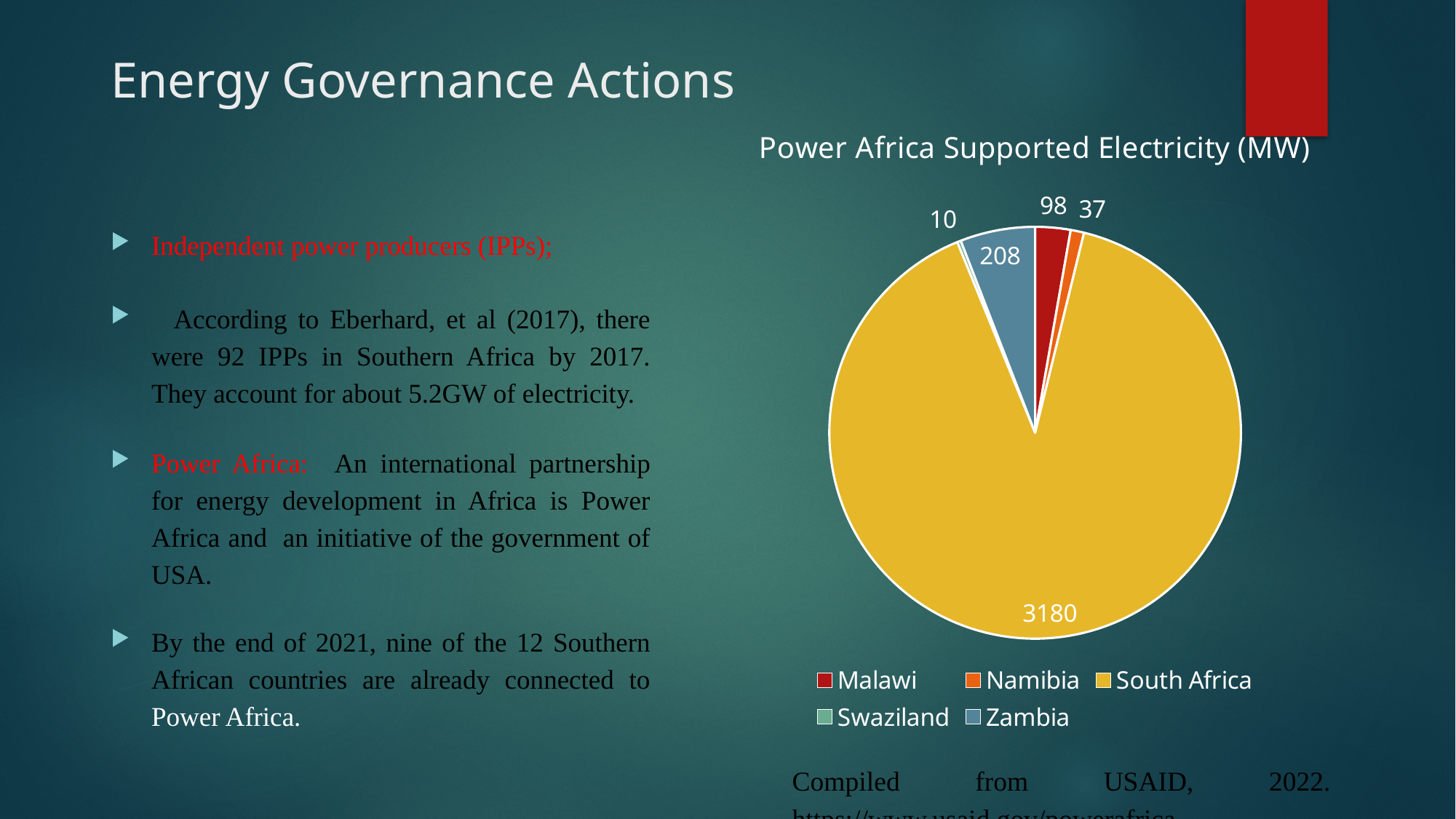
What is the total of all the values shown in the pie chart? 3533 What is the value for Malawi in the pie chart? 98 Which is larger, the value for Malawi or the value for Namibia? Malawi How many countries are listed in the chart legend? 5 What is the value for Zambia in the pie chart? 208 What is the title of the chart? Power Africa Supported Electricity (MW) What is the difference between the values for Zambia and Malawi? 110 What is the value for South Africa in the pie chart? 3180 What is the value for Swaziland in the pie chart? 10 Which country has the smallest slice in the pie chart? Swaziland Which country has the largest slice in the pie chart? South Africa What type of chart is shown on the slide? Pie chart